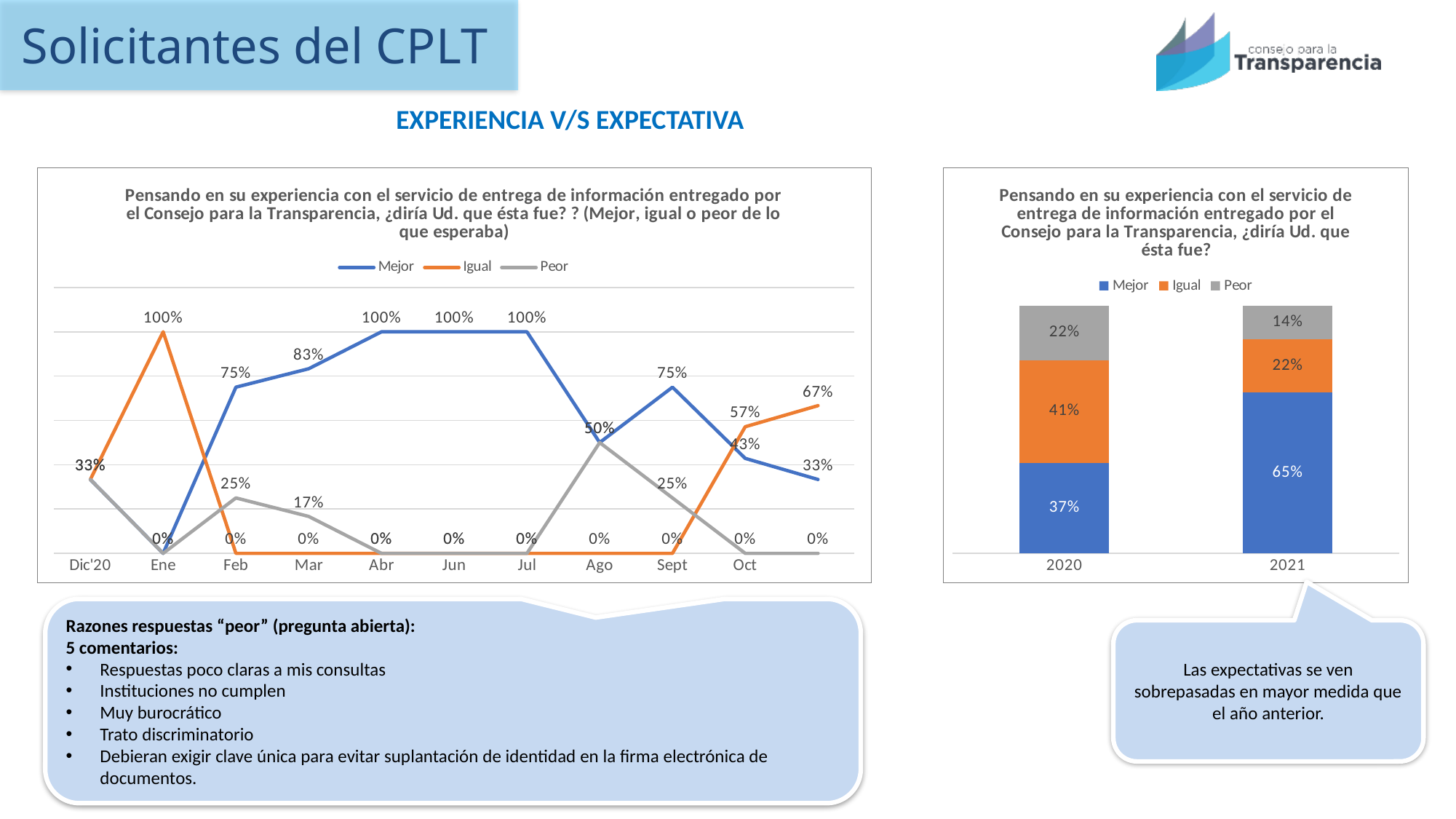
In the left-hand line chart, what is the value of "Mejor" in Mar? 83% In the right-hand stacked bar chart, by how many percentage points did "Mejor" increase from 2020 to 2021? 28 percentage points In the left-hand line chart, what is the value of "Peor" in Feb? 25% In the right-hand stacked bar chart, is the "Igual" share larger in 2020 or in 2021? 2020 In the right-hand stacked bar chart, what percentage of respondents answered "Mejor" in 2021? 65% What kind of chart is the left-hand chart showing monthly results? Line chart In the left-hand line chart, does the "Mejor" series rise or fall between Jul and Oct? Fall In the right-hand stacked bar chart, what is the value for "Peor" in 2020? 22% What kind of chart is the right-hand chart comparing 2020 and 2021? Stacked bar chart In the left-hand line chart, what is the value of "Igual" in Oct? 57% How many series does the legend of the right-hand chart list? 3 In the left-hand line chart, what is the value of "Igual" in Ene? 100%